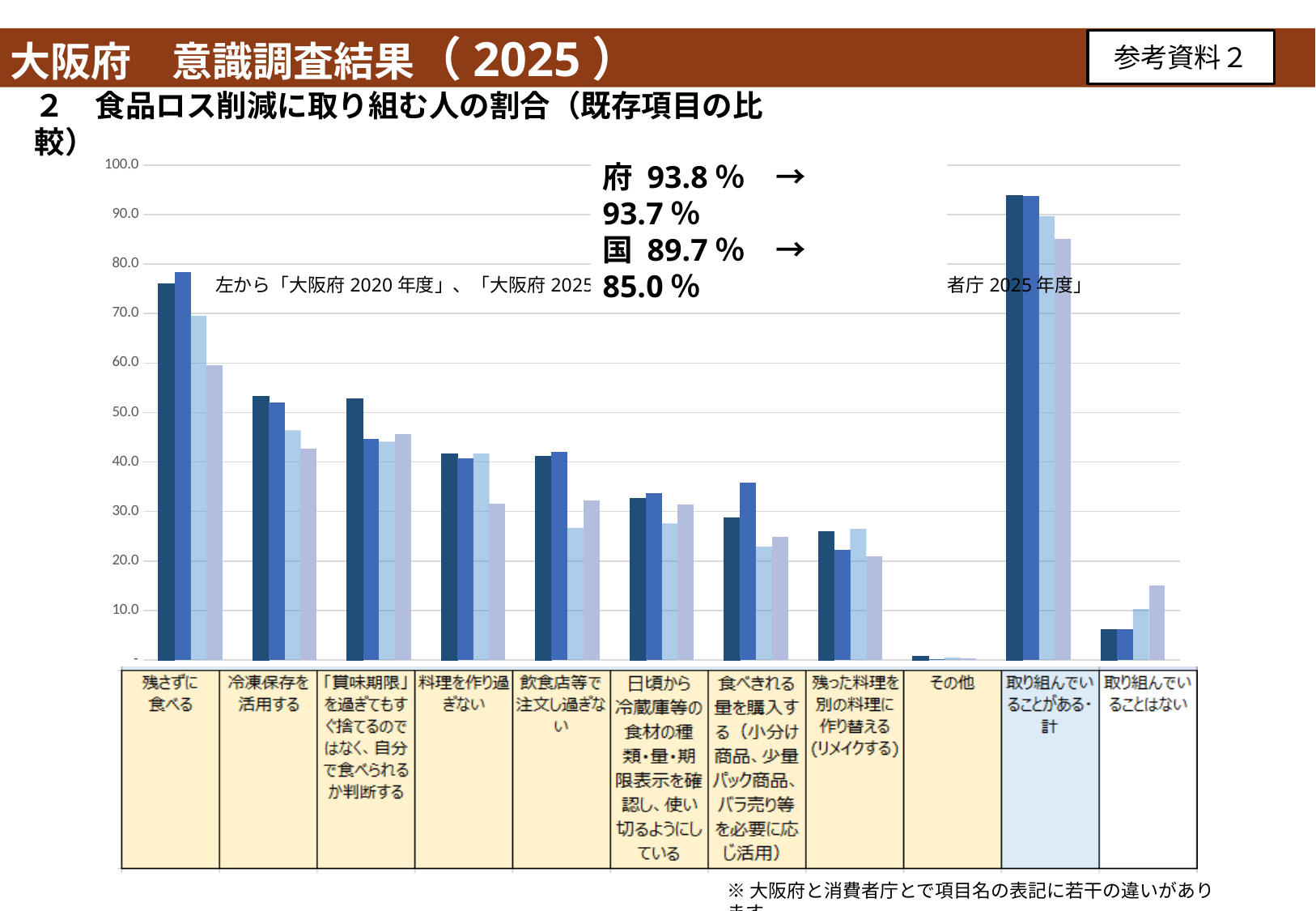
Are all the bars for 取り組んでいることはない greater or less than 20.0? less Is the leftmost bar for 残さずに食べる greater or less than 70.0? greater What kind of chart is shown on the slide? bar chart Which category has the lowest bars in the chart? その他 Which category has a taller leftmost bar, 残さずに食べる or 冷凍保存を活用する? 残さずに食べる How many categories are shown along the x axis of the chart? 11 Is the leftmost bar for 冷凍保存を活用する greater or less than 50.0? greater According to the annotation on the chart, by how many percentage points did the 国 value fall from 89.7% to 85.0%? 4.7 Which category has the tallest bars in the chart? 取り組んでいることがある・計 How many bars are plotted for each category in the chart? 4 According to the annotation on the chart, what is the 2025 value for 府 (Osaka Prefecture)? 93.7%